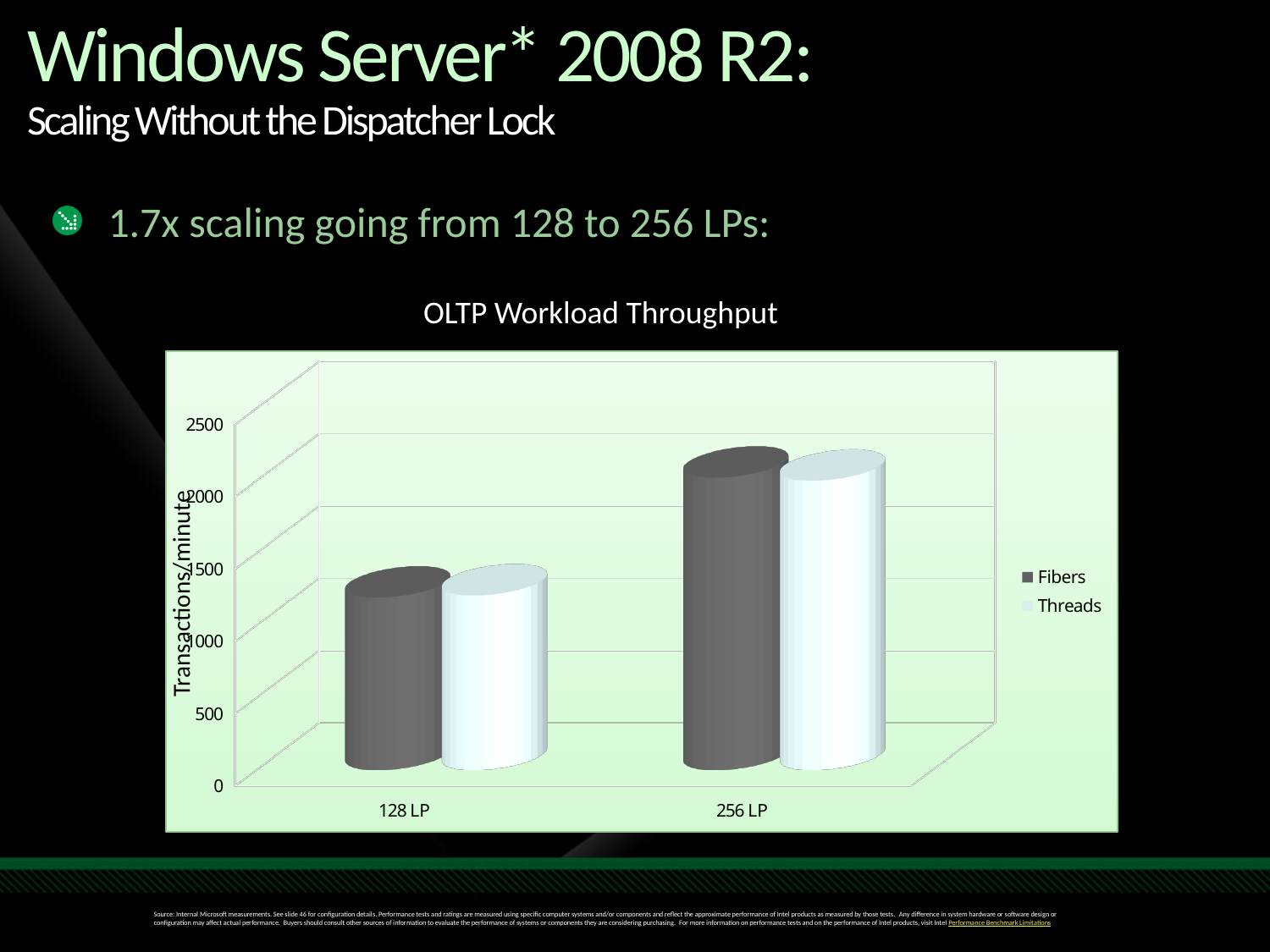
Is the Threads value for 128 LP greater or less than 2000? less Is the Fibers value for 128 LP greater or less than 1000? greater For the Fibers series, which category has the higher value, 128 LP or 256 LP? 256 LP Do the Threads values rise or fall going from 128 LP to 256 LP? rise What type of chart is shown on the slide? bar chart What are the two series named in the legend? Fibers and Threads How many series does the chart legend list? 2 Is the Fibers value for 256 LP greater or less than 1500? greater What is the label of the vertical axis? Transactions/minute How many categories are shown on the x axis? 2 What is the title of the chart? OLTP Workload Throughput